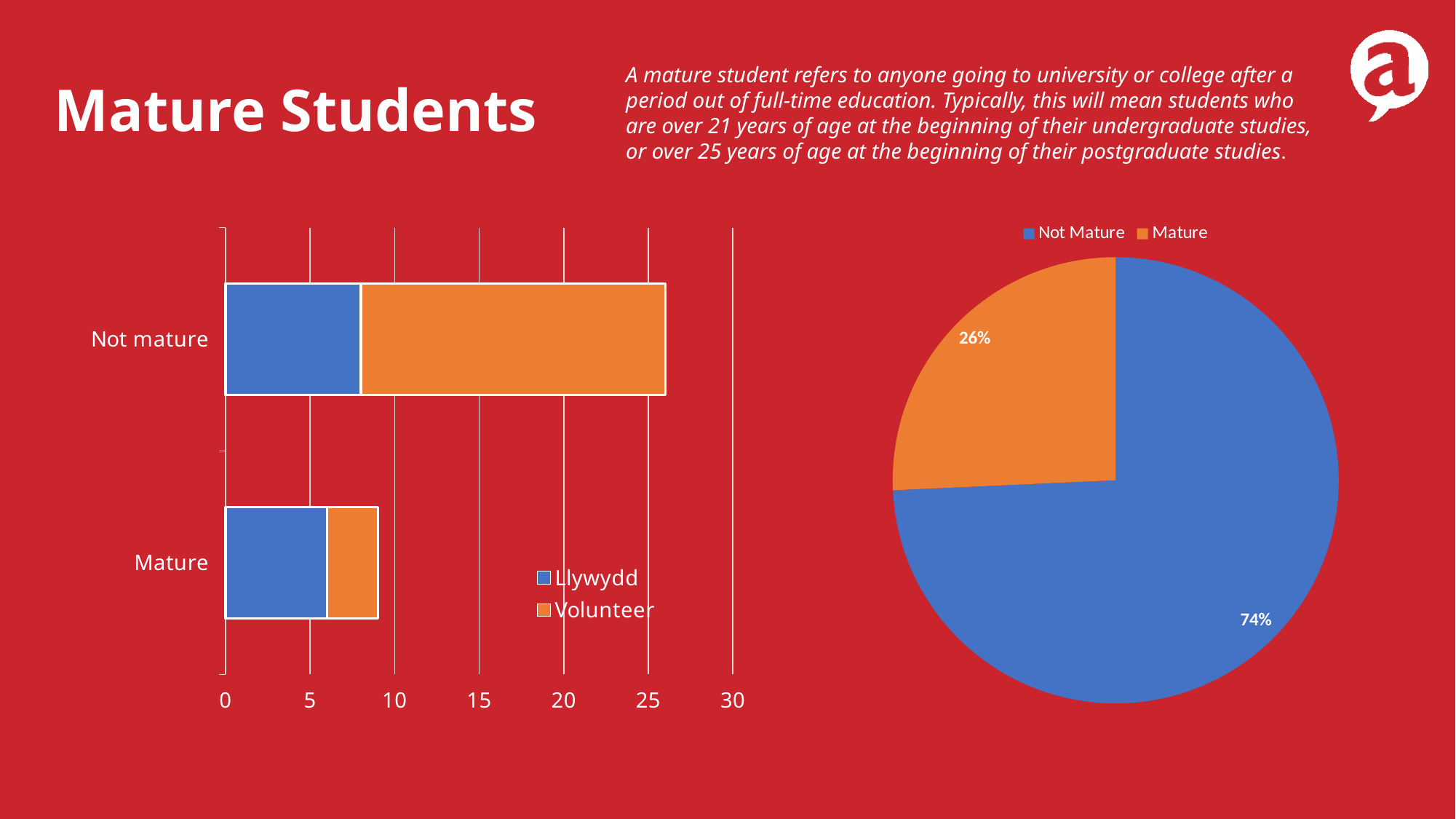
How many slices does the pie chart on the right have? 2 What kind of chart is the chart on the left of the slide? Bar chart In the pie chart on the right, what is the difference in percentage points between the Not Mature and Mature slices? 48% In the pie chart on the right, what percentage is shown for Not Mature? 74% In the pie chart on the right, which slice is larger, Not Mature or Mature? Not Mature In the bar chart on the left, is the Llywydd value for Not mature greater or less than 10? less How many series does the legend of the bar chart on the left list? 2 In the bar chart on the left, which series has the larger value for Not mature, Llywydd or Volunteer? Volunteer In the bar chart on the left, which category has the longer total bar, Not mature or Mature? Not mature In the pie chart on the right, what percentage is shown for Mature? 26% In the bar chart on the left, is the total for Mature greater or less than 10? less In the bar chart on the left, is the Volunteer value for Not mature greater or less than 15? greater